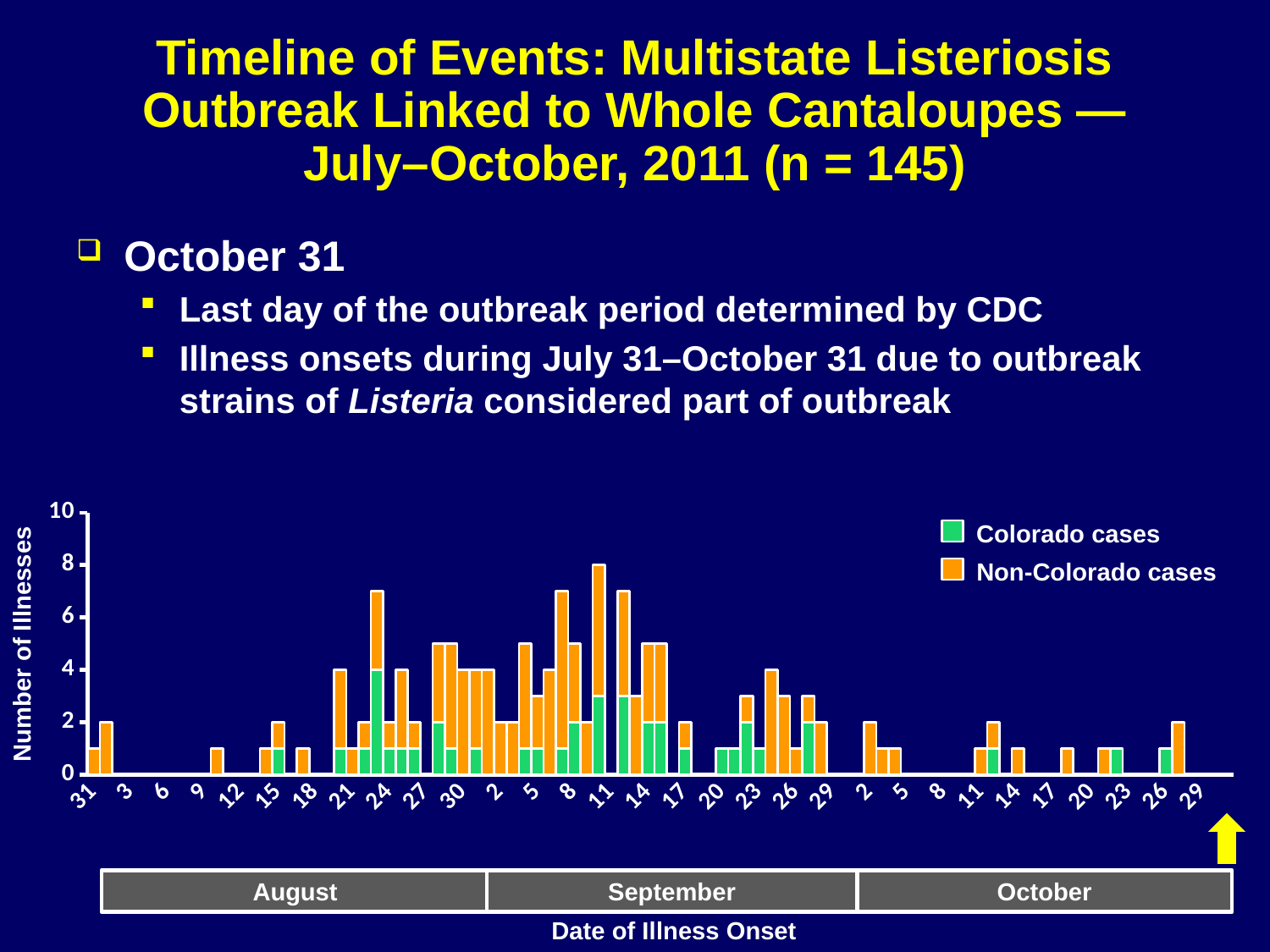
Do the numbers of illnesses generally rise or fall from mid-September through the end of October? fall What is the total number of illnesses for September 11? 0 Is the number of illnesses for September 11 greater or less than 6? less Is the number of illnesses for October 2 greater or less than 4? less What are the two series named in the chart's legend? Colorado cases and Non-Colorado cases Is the number of illnesses for August 9 greater or less than 2? less What colour represents Colorado cases in the chart? green How many series does the chart's legend list? 2 Which has more illnesses, September 11 or October 2? October 2 What kind of chart is shown on the slide? bar chart Which date of illness onset has the highest number of illnesses? September 10